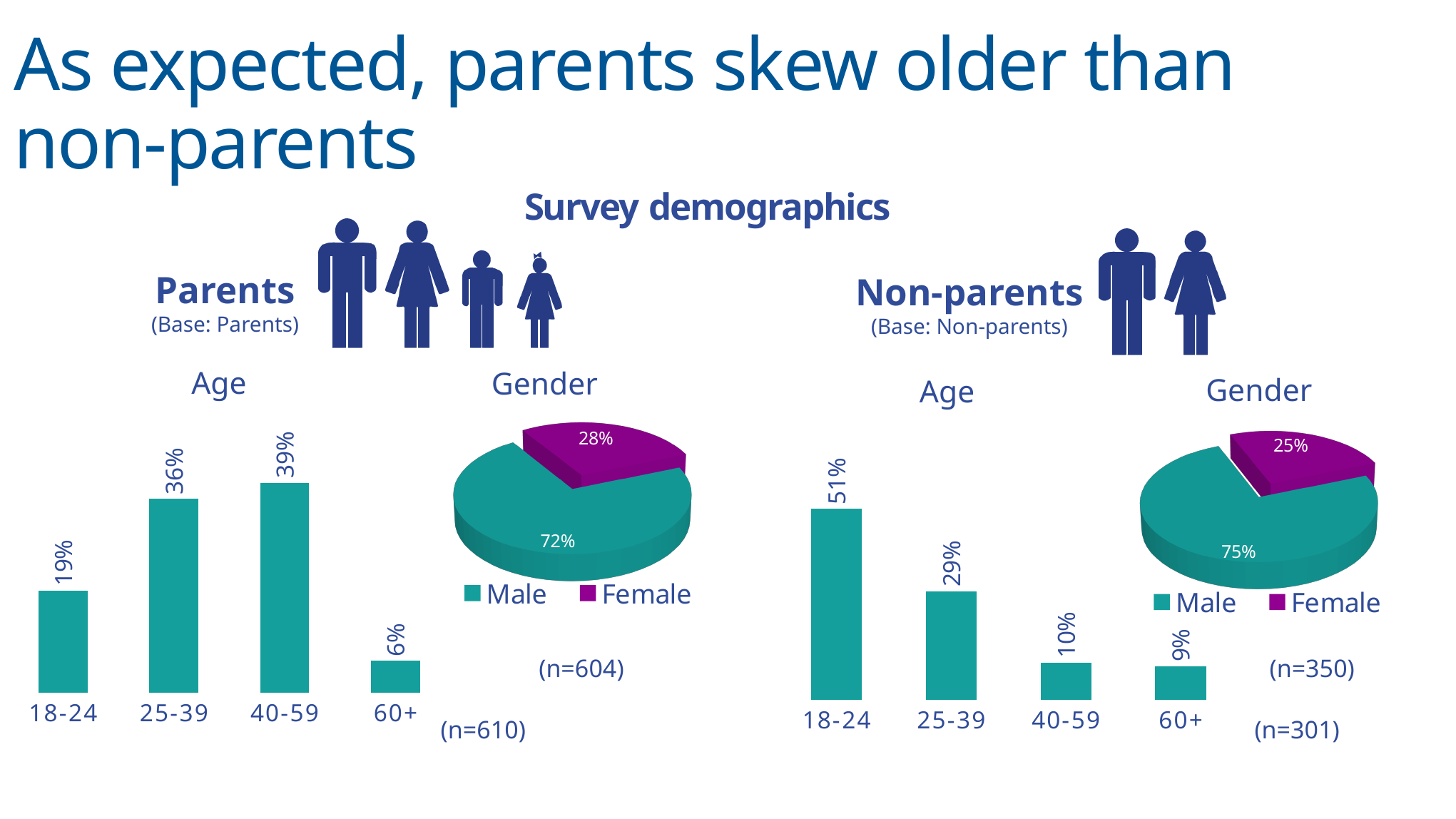
In the Parents Gender pie chart, what share is Female? 28% What kind of chart is used to show Gender for Parents? Pie chart Which is larger: the 25-39 value in the Parents Age chart or the 25-39 value in the Non-parents Age chart? Parents (36%) In the Parents Age bar chart, what is the difference between the 40-59 and 18-24 values? 20% How many series does the legend of the Non-parents Gender pie chart list? 2 In the Non-parents Age bar chart, which age group has the highest value? 18-24 In the Non-parents Age bar chart, what is the value for the 18-24 age group? 51% In the Non-parents Gender pie chart, what share is Male? 75% In the Non-parents Age bar chart, what is the difference between the 18-24 and 25-39 values? 22% In the Parents Age bar chart, which age group has the lowest value? 60+ In the Parents Age bar chart, what is the value for the 40-59 age group? 39% How many age groups are shown in the Parents Age bar chart? 4